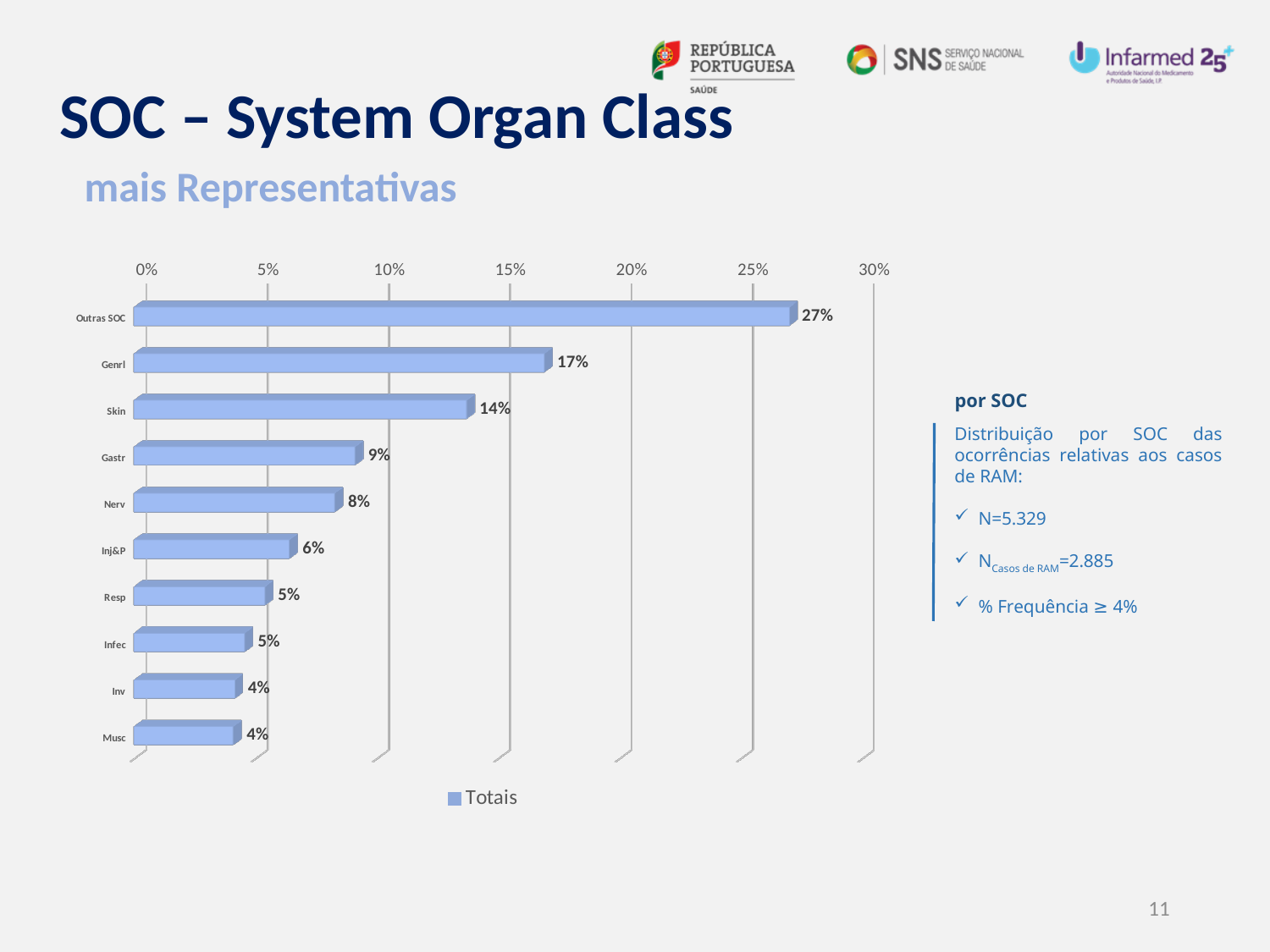
What is the difference between the values for Genrl and Skin? 3% How many series does the legend list? 1 How many categories are shown on the chart? 10 What is the value for Outras SOC? 27% What is the value for Gastr? 9% Which category has the highest value? Outras SOC Is the value for Genrl greater or less than 15%? greater What is the value for Inj&P? 6% What is the value for Skin? 14% Which is larger, the value for Nerv or the value for Resp? Nerv What is the difference between the values for Outras SOC and Nerv? 19% What kind of chart is shown on the slide? bar chart